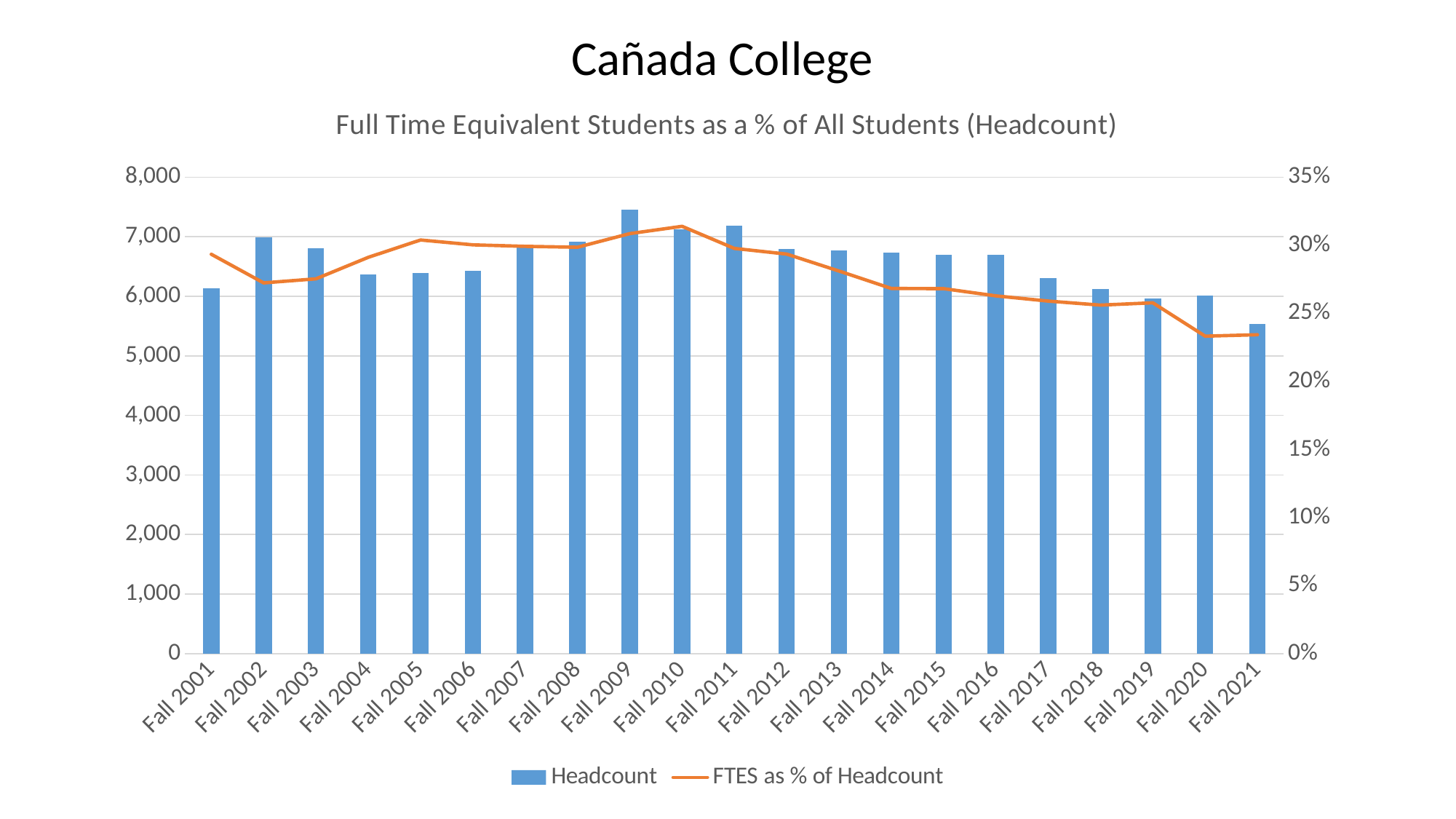
What kind of chart is shown on the slide? A combined bar and line chart Does FTES as % of Headcount rise or fall from Fall 2010 to Fall 2021? fall How many Fall terms are shown on the x axis? 21 Is FTES as % of Headcount for Fall 2010 greater or less than 30%? greater Which Fall term has the highest Headcount? Fall 2009 Is FTES as % of Headcount for Fall 2021 greater or less than 25%? less Is the Headcount for Fall 2021 greater or less than 6,000? less Which has the larger Headcount, Fall 2002 or Fall 2004? Fall 2002 How many series does the legend list? 2 Which Fall term has the lowest Headcount? Fall 2021 In which Fall term is FTES as % of Headcount highest? Fall 2010